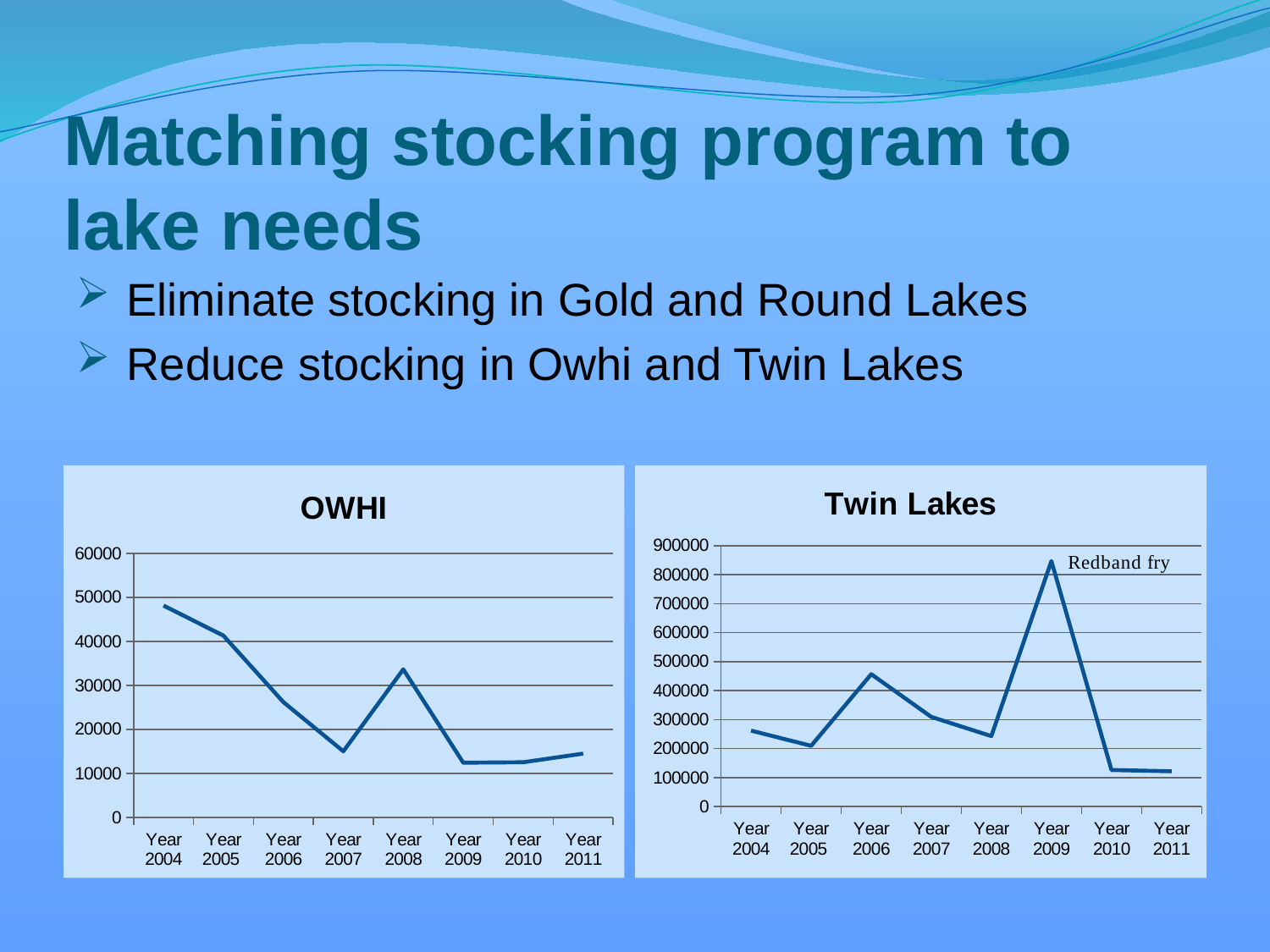
On the OWHI chart, which is larger, the value for Year 2004 or Year 2008? Year 2004 On the Twin Lakes chart, what text label is placed next to the peak at Year 2009? Redband fry On the Twin Lakes chart, is the value for Year 2009 greater or less than 800000? greater On the Twin Lakes chart, is the value for Year 2010 greater or less than 200000? less What kind of chart is the OWHI chart? Line chart On the OWHI chart, which year has the highest value? Year 2004 On the Twin Lakes chart, which is larger, the value for Year 2006 or Year 2007? Year 2006 On the OWHI chart, is the value for Year 2007 greater or less than 20000? less On the OWHI chart, do the values generally rise or fall from Year 2004 to Year 2011? Fall How many years are plotted on the Twin Lakes chart? 8 On the Twin Lakes chart, which year has the highest value? Year 2009